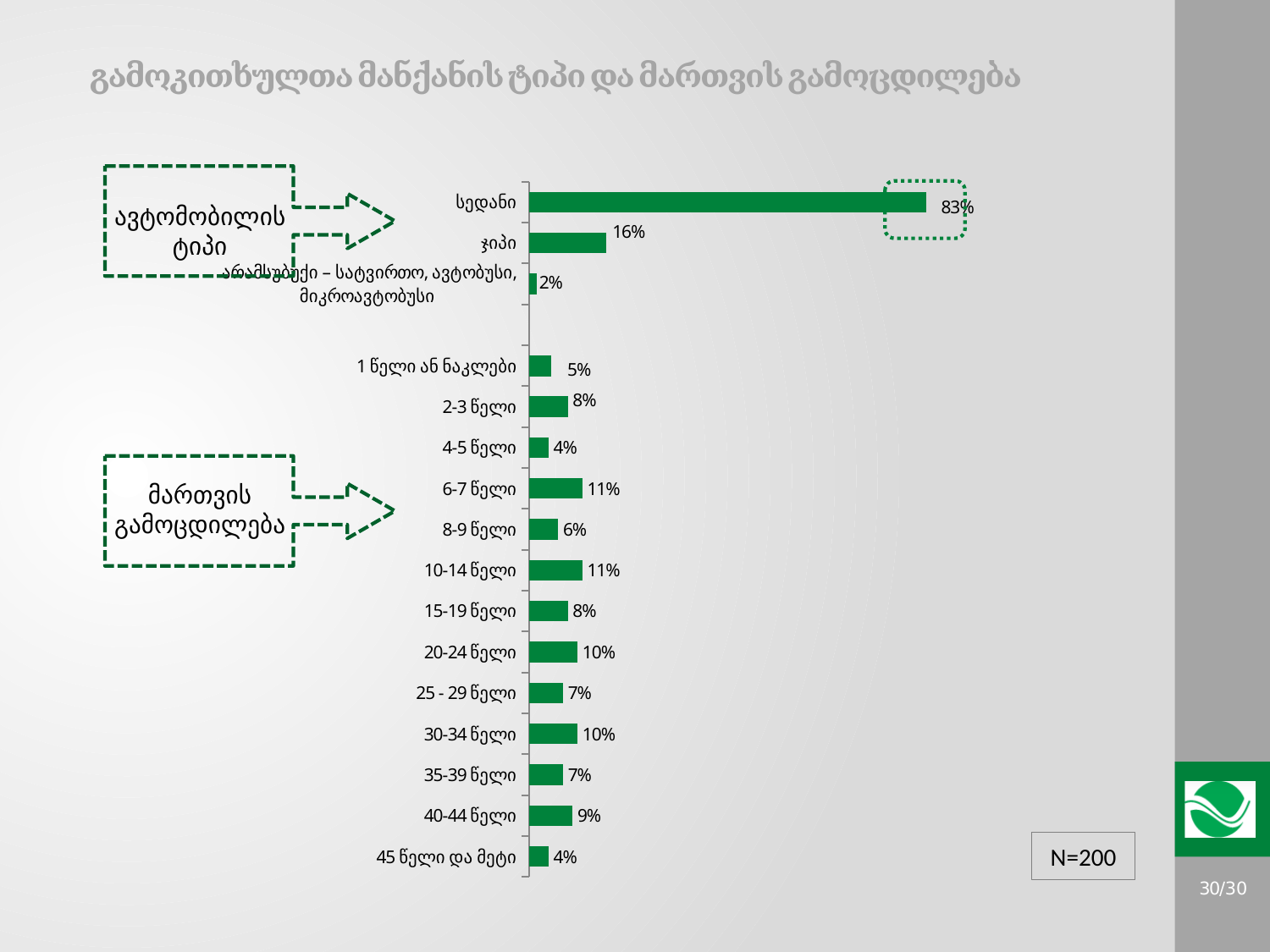
What is the difference between the values for სედანი and ჯიპი? 67% What sample size (N) is shown on the slide? N=200 Which category has the highest value in the chart? სედანი What is the value for სედანი? 83% Which is larger, the value for 2-3 წელი or the value for 4-5 წელი? 2-3 წელი What type of chart is shown on the slide? bar chart What is the value for 45 წელი და მეტი? 4% How many categories are plotted in the chart? 16 What is the difference between the values for 20-24 წელი and 25 - 29 წელი? 3% What is the value for 6-7 წელი? 11% Which is larger, the value for 40-44 წელი or the value for 8-9 წელი? 40-44 წელი What is the value for ჯიპი? 16%